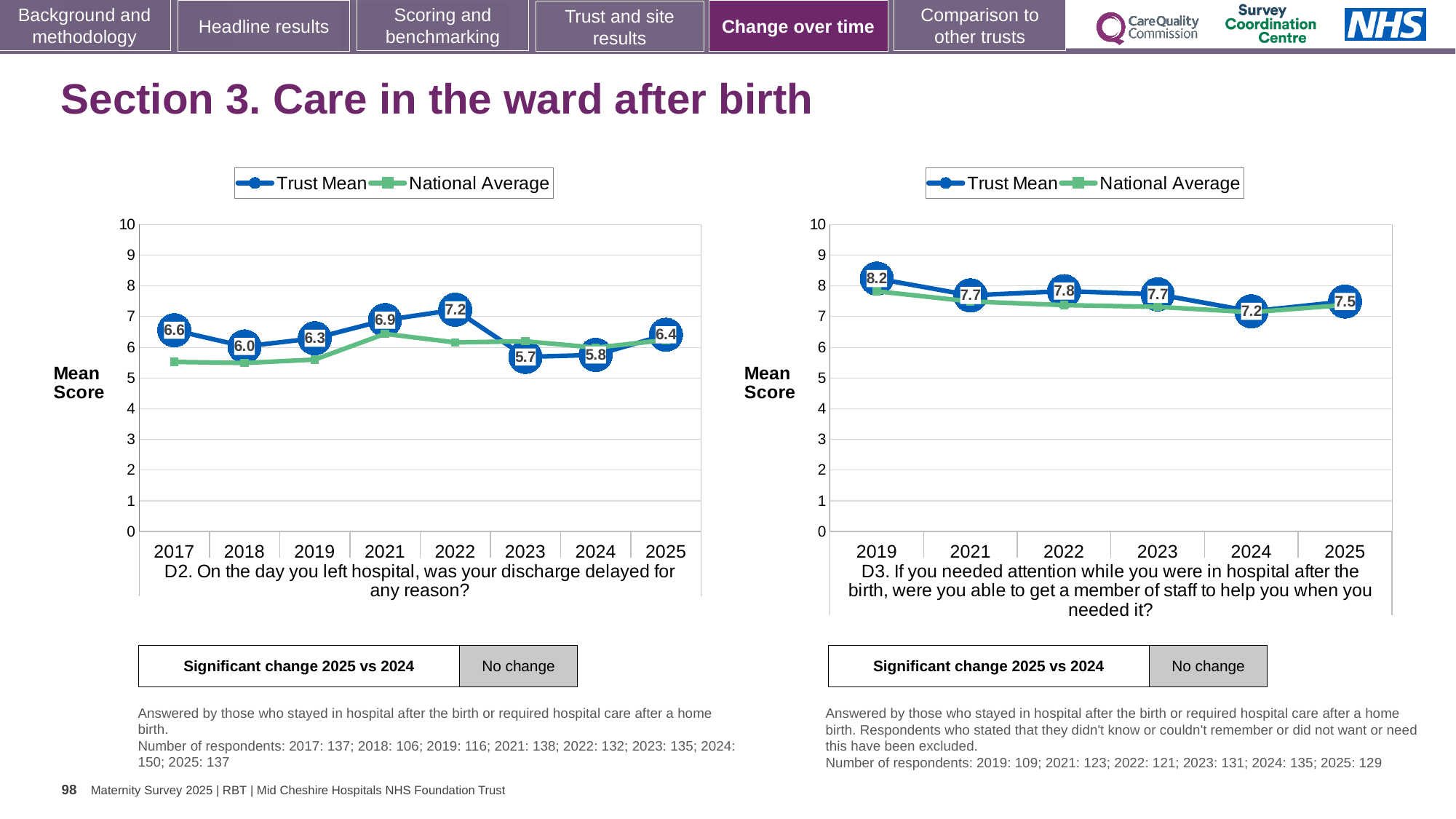
In the D2 chart (left), what is the difference between the Trust Mean scores for 2022 and 2023? 1.5 In the D3 chart (right), what is the Trust Mean score for 2019? 8.2 In the D3 chart (right), is the Trust Mean score for 2024 greater or less than the score for 2025? less In the D2 chart (left), what is the Trust Mean score for 2022? 7.2 In the D2 chart (left), which year has the lowest Trust Mean score? 2023 In the D2 chart (left), how many years are shown on the x axis? 8 What kind of chart is the D2 chart (left)? Line chart In the D3 chart (right), what is the difference between the Trust Mean scores for 2019 and 2025? 0.7 In the D2 chart (left), which year has the highest Trust Mean score? 2022 In the D3 chart (right), which year has the lowest Trust Mean score? 2024 In the D2 chart (left), what is the Trust Mean score for 2025? 6.4 How many series does the legend of the D3 chart (right) list? 2